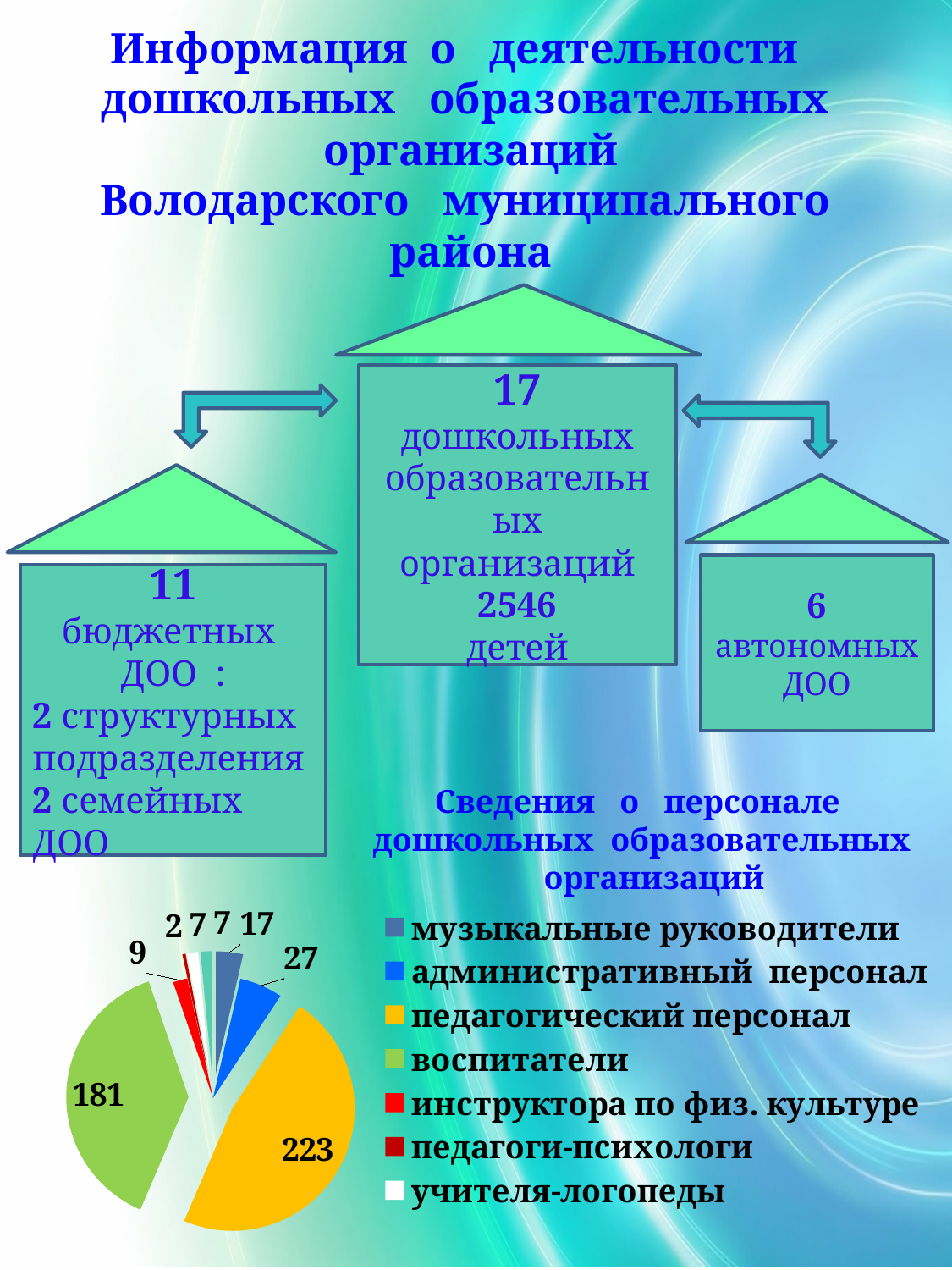
Which category has the smallest slice in the pie chart? педагоги-психологи What is the value for административный персонал in the pie chart? 27 How many entries does the legend of the pie chart list? 7 What is the value for воспитатели in the pie chart? 181 What is the value for инструктора по физ. культуре in the pie chart? 9 Which is larger in the pie chart: административный персонал or музыкальные руководители? административный персонал What kind of chart is shown at the bottom of the slide? pie chart What is the value for педагогический персонал in the pie chart? 223 What is the value for педагоги-психологи in the pie chart? 2 What is the value for музыкальные руководители in the pie chart? 17 What is the difference between the values for педагогический персонал and воспитатели in the pie chart? 42 Which category has the largest slice in the pie chart? педагогический персонал